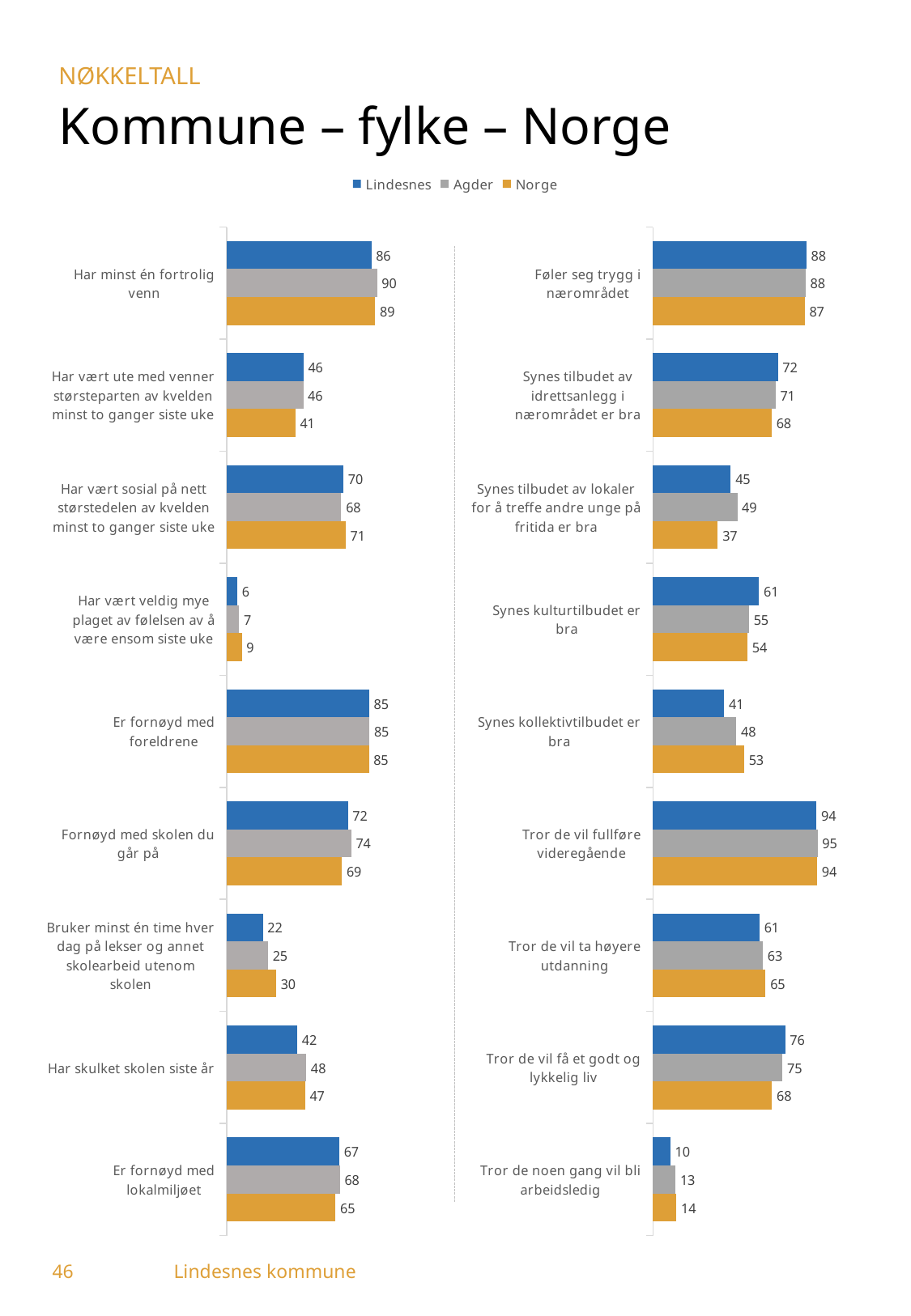
In the right chart, which category has the highest value for Lindesnes? Tror de vil fullføre videregående Which series is shown in orange in the legend? Norge In the left chart, what is the value for Agder for 'Har skulket skolen siste år'? 48 In the right chart, for 'Synes kollektivtilbudet er bra', which is larger: the Lindesnes value or the Agder value? Agder How many categories does the left chart show? 9 What kind of chart is used on this slide? Bar chart In the right chart, what is the difference between the Lindesnes and Norge values for 'Tror de vil få et godt og lykkelig liv'? 8 In the right chart, what is the value for Norge for 'Synes tilbudet av lokaler for å treffe andre unge på fritida er bra'? 37 How many series does the legend list? 3 In the left chart, for 'Bruker minst én time hver dag på lekser og annet skolearbeid utenom skolen', which is larger: the Lindesnes value or the Norge value? Norge In the left chart, what is the value for Lindesnes for 'Har minst én fortrolig venn'? 86 In the left chart, which category has the lowest value for Norge? Har vært veldig mye plaget av følelsen av å være ensom siste uke